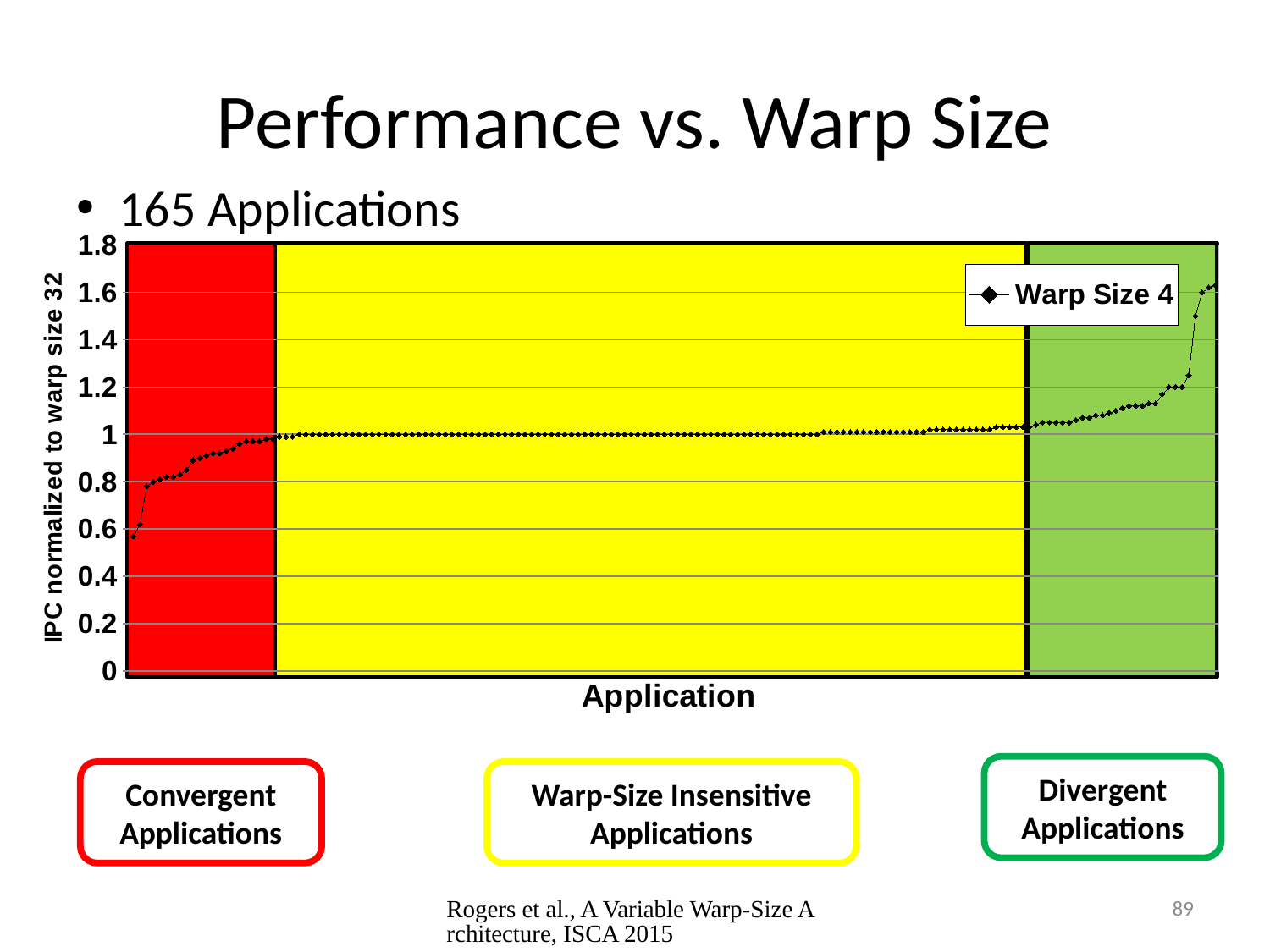
What is the label of the y axis? IPC normalized to warp size 32 Which region of the chart contains the highest plotted values: the red, yellow, or green region? green Is the value for the rightmost application greater or less than 1.4? greater What is the highest tick value shown on the y axis? 1.8 What kind of chart is shown on the slide? line chart What is the name of the series shown in the chart legend? Warp Size 4 Is the value for the leftmost application greater or less than 0.8? less Which region of the chart contains the lowest plotted values: the red, yellow, or green region? red Do the plotted values rise or fall from left to right along the x axis? rise Are the values in the yellow (Warp-Size Insensitive) region greater or less than 1.2? less How many series does the chart legend list? 1